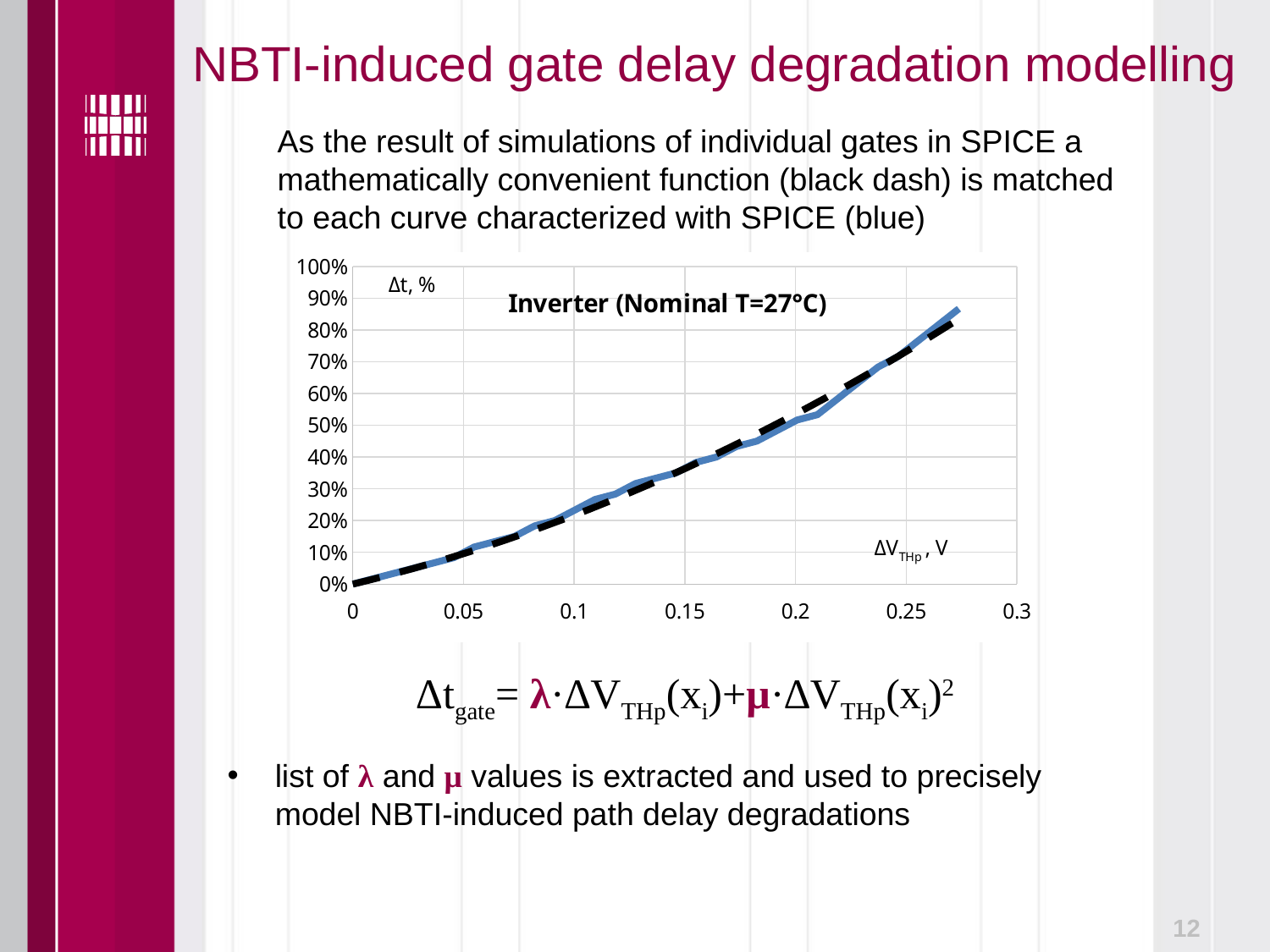
Is the value of the blue curve at ΔVTHp = 0.1 V greater or less than 30%? less Which of the two values of the blue curve is larger: at ΔVTHp = 0.1 V or at ΔVTHp = 0.2 V? at ΔVTHp = 0.2 V What is the label on the vertical axis of the chart? Δt, % What is the title of the chart? Inverter (Nominal T=27°C) Is the value of the blue curve at ΔVTHp = 0.15 V greater or less than 30%? greater Is the highest value reached by the blue curve greater or less than 80%? greater What is the value of the blue curve at ΔVTHp = 0 V? 0% What is the largest value shown on the x axis of the chart? 0.3 What kind of chart is shown on the slide? line chart Do the values of the blue curve rise or fall as ΔVTHp increases along the x axis? rise